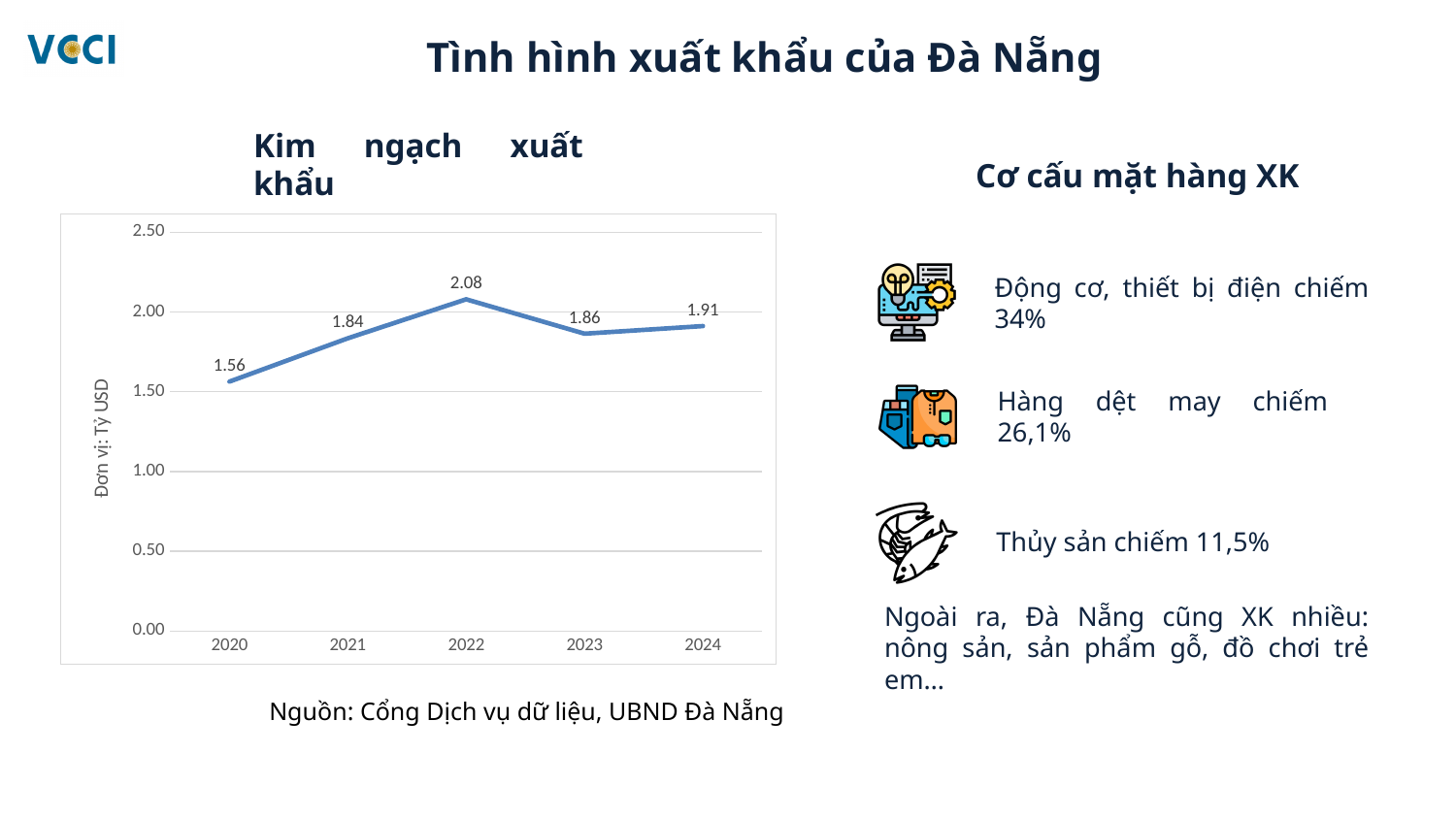
What value is shown for 2020? 1.56 Which year has the lowest export turnover? 2020 What is the difference between the 2022 and 2020 values? 0.52 How many years are plotted on the chart? 5 Which is larger, the value for 2021 or the value for 2023? 2023 What was the export turnover in 2022? 2.08 Which year has the highest export turnover? 2022 What kind of chart is shown on the slide? line chart What is the value for 2024? 1.91 What unit is given on the vertical axis of the chart? Tỷ USD Is the value for 2022 greater or less than 2.00? greater What is the difference between the 2024 and 2023 values? 0.05